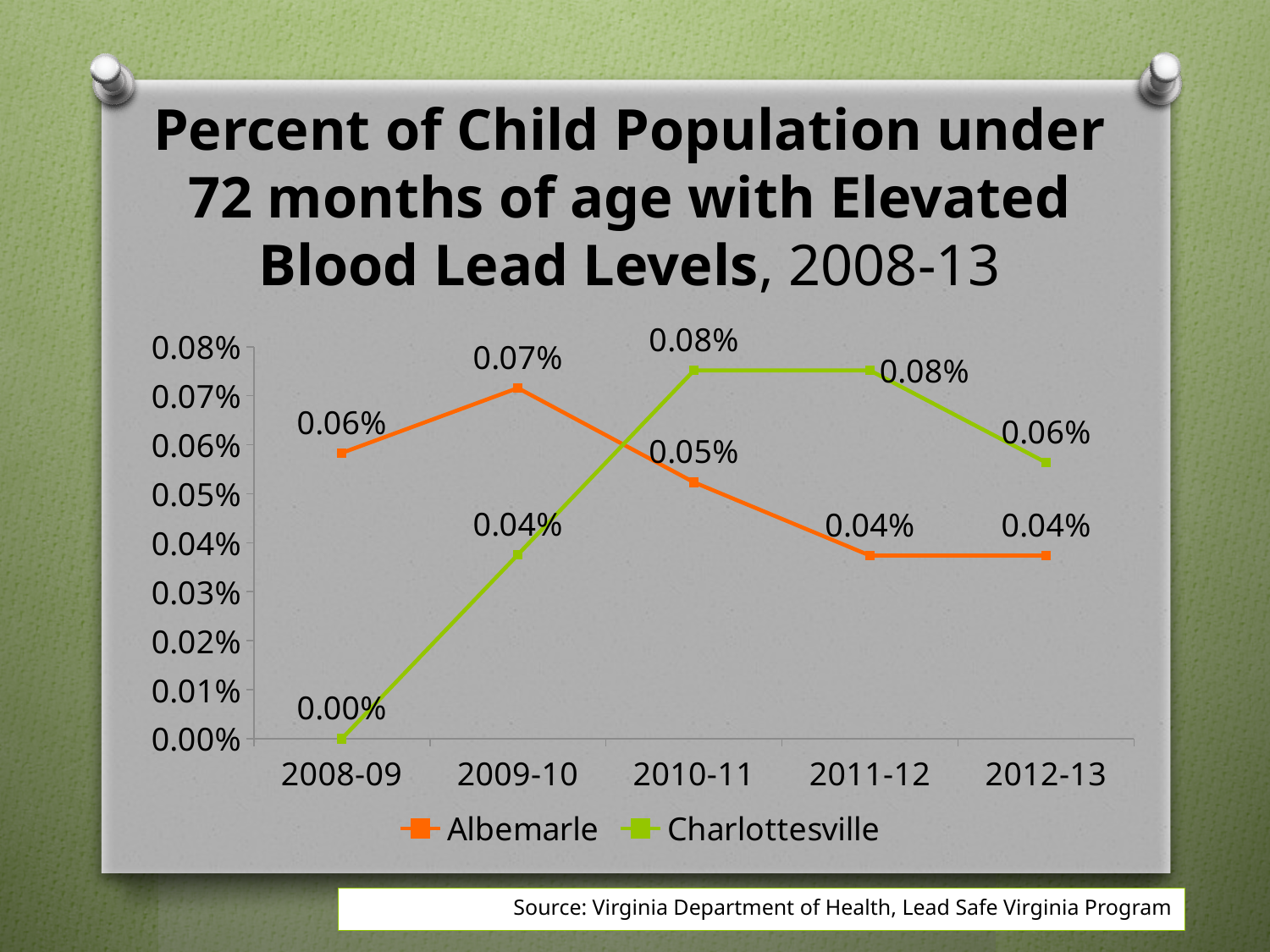
Does the Albemarle line rise or fall from 2009-10 to 2012-13? Fall What is the value for Albemarle in 2009-10? 0.07% How many series does the legend list? 2 What is the difference between the Charlottesville values in 2010-11 and 2008-09? 0.08% How many school-year periods are shown on the x axis? 5 What is the value for Charlottesville in 2008-09? 0.00% What type of chart is shown on the slide? Line chart In which period is the Albemarle value highest? 2009-10 What is the value for Charlottesville in 2012-13? 0.06% In 2010-11, which is higher, Albemarle or Charlottesville? Charlottesville In which period is the Charlottesville value lowest? 2008-09 What is the value for Albemarle in 2010-11? 0.05%